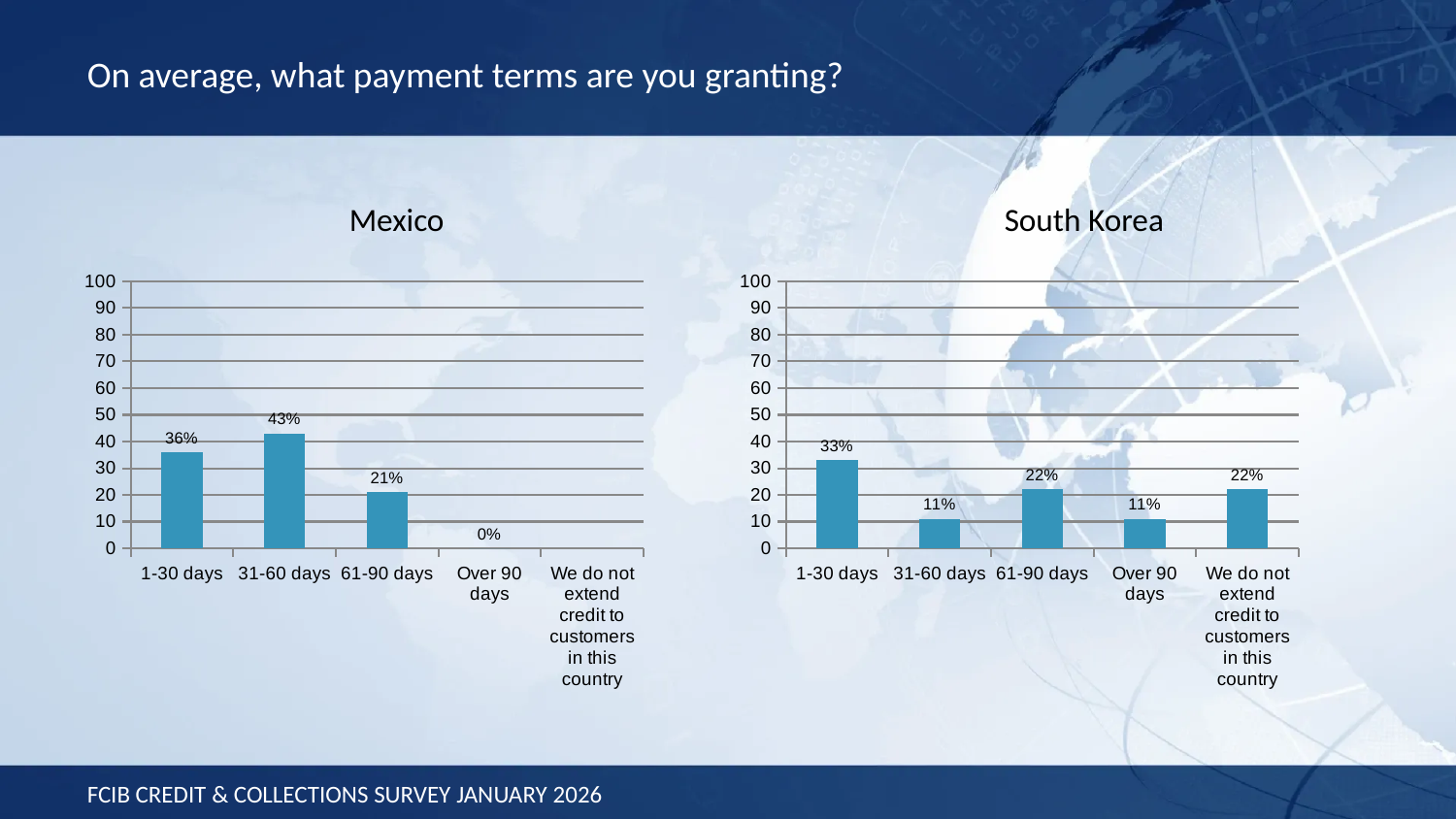
In the Mexico chart, is the value for 1-30 days greater or less than 30? greater In the South Korea chart, what is the value for Over 90 days? 11% What type of chart is the Mexico chart? Bar chart In the Mexico chart, what is the difference between the values for 31-60 days and 1-30 days? 7% In the South Korea chart, what is the value for 1-30 days? 33% In the South Korea chart, which is larger, the value for 61-90 days or the value for 31-60 days? 61-90 days In the Mexico chart, what is the value for 31-60 days? 43% In the South Korea chart, which payment term category has the highest value? 1-30 days In the Mexico chart, what is the value for 61-90 days? 21% How many categories are shown on the x axis of the South Korea chart? 5 In the Mexico chart, which payment term category has the highest value? 31-60 days In the South Korea chart, what is the difference between the values for 1-30 days and 61-90 days? 11%